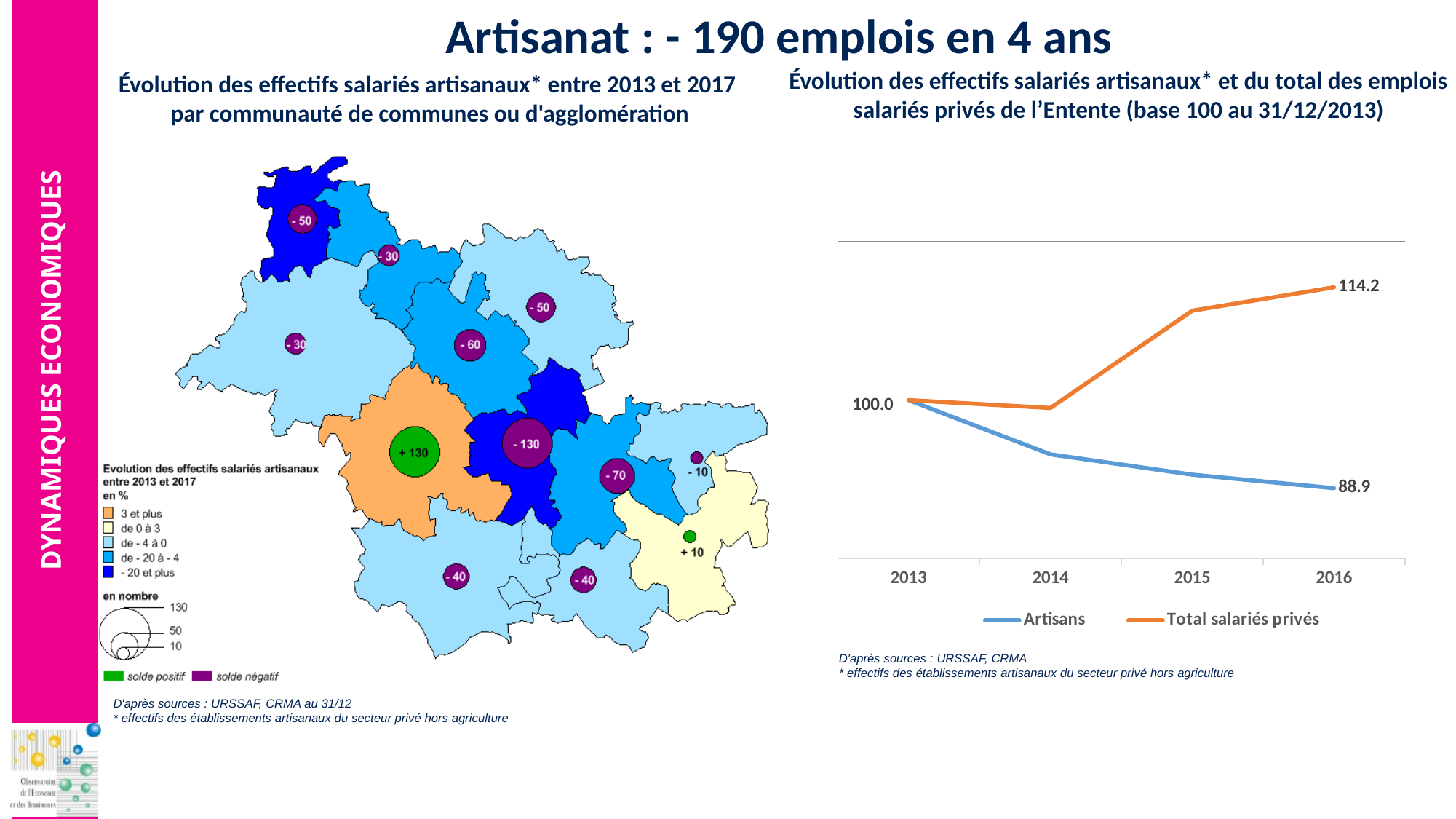
What kind of chart is shown on the right side of the slide (Évolution des effectifs salariés artisanaux et du total des emplois salariés privés)? line chart In the line chart on the right, what is the value of the Artisans series in 2016? 88.9 In the line chart on the right, is the value for Artisans in 2014 greater or less than 100? less In the map on the left, what is the largest positive change in artisan employees shown by a bubble? + 130 In the line chart on the right, does the Artisans series rise or fall from 2013 to 2016? fall In the line chart on the right, which series has the higher value in 2016, Artisans or Total salariés privés? Total salariés privés In the line chart on the right, how many years are shown on the x axis? 4 In the line chart on the right, what is the value of the Total salariés privés series in 2016? 114.2 In the line chart on the right, what is the difference between the Total salariés privés and Artisans values in 2016? 25.3 In the line chart on the right, is the value for Total salariés privés in 2015 greater or less than 100? greater In the line chart on the right, how many series does the legend list? 2 In the line chart on the right, what value do both series start at in 2013? 100.0